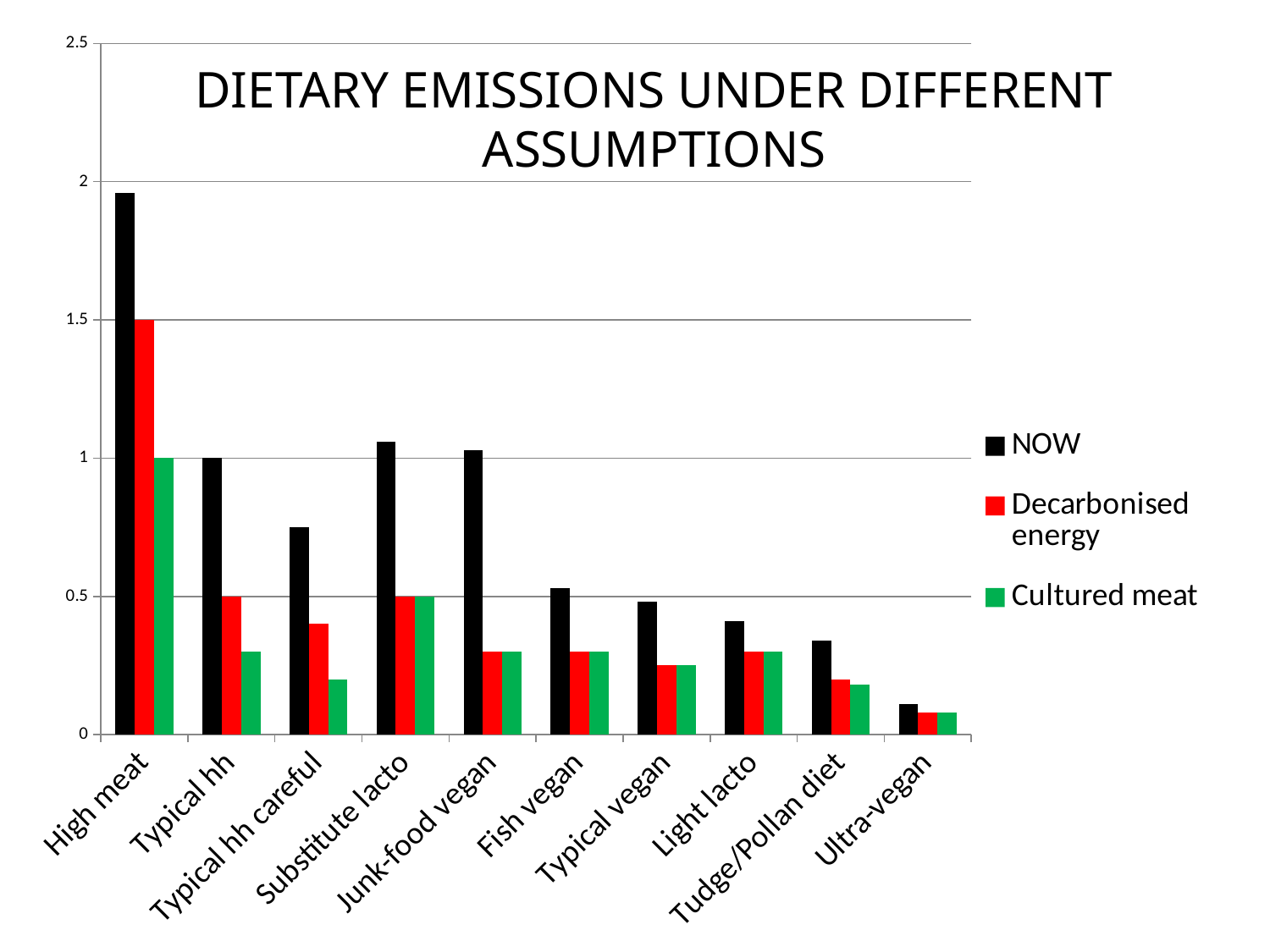
Which is larger, the Decarbonised energy value for High meat or the Decarbonised energy value for Typical hh? High meat Is the NOW value for Typical hh careful greater or less than 0.5? greater Is the Cultured meat value for Typical hh greater or less than 0.5? less Which diet has the lowest NOW value? Ultra-vegan What is the title of the chart? DIETARY EMISSIONS UNDER DIFFERENT ASSUMPTIONS Which is larger, the NOW value for Substitute lacto or the NOW value for Fish vegan? Substitute lacto Which diet has the highest NOW value? High meat How many series does the legend list? 3 How many diet categories are shown on the x axis? 10 What kind of chart is shown on the slide? bar chart Which series is shown in green in the legend? Cultured meat Is the NOW value for High meat greater or less than 1.5? greater